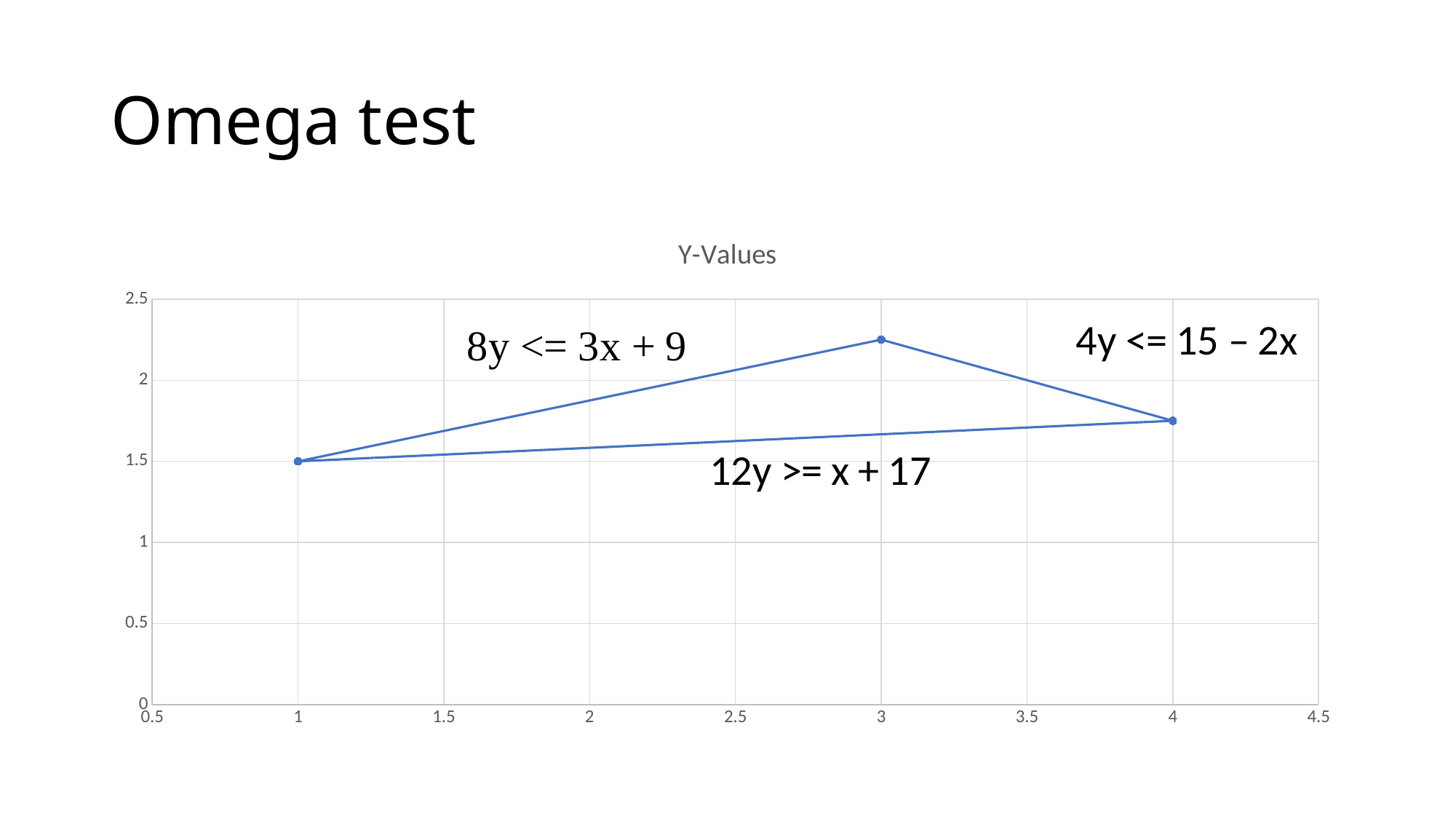
At which x-value does the plotted point have the lowest y-value? 1 Do the y-values rise or fall between x = 1 and x = 3? rise Is the y-value of the point at x = 4 greater or less than 2? less Which inequality is written above the line connecting the points at x = 1 and x = 3? 8y <= 3x + 9 What kind of chart is shown on the slide? scatter chart with connected lines What is the y-value of the point at x = 1? 1.5 How many data points are plotted on the chart? 3 Is the y-value of the point at x = 3 greater or less than 2? greater At which x-value does the plotted point have the highest y-value? 3 What is the title of the chart? Y-Values Which point has the larger y-value, the one at x = 3 or the one at x = 4? x = 3 Is the y-value of the point at x = 4 greater or less than 1.5? greater